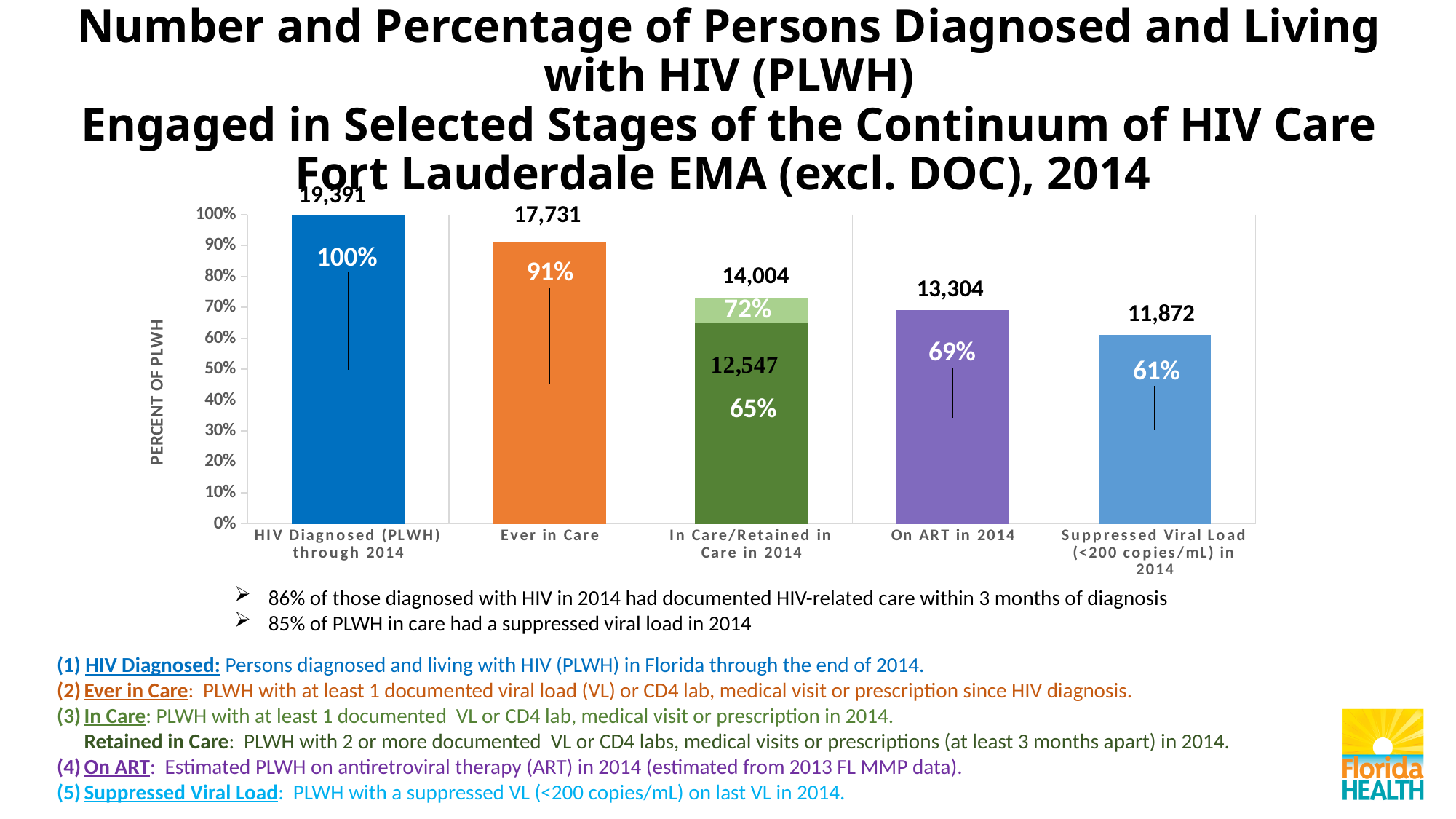
What percentage of PLWH is shown for the Ever in Care bar? 91% Which stage of the continuum has the lowest percentage of PLWH? Suppressed Viral Load (<200 copies/mL) in 2014 What percentage is shown for Suppressed Viral Load (<200 copies/mL) in 2014? 61% What percentage is shown for Retained in Care (the darker green portion of the In Care/Retained in Care bar)? 65% What type of chart is shown on the slide? Bar chart What number is printed above the On ART in 2014 bar? 13,304 How many stages of the continuum are shown on the x axis? 5 What is the difference in percentage points between Ever in Care and On ART in 2014? 22% What number is printed above the HIV Diagnosed (PLWH) through 2014 bar? 19,391 Which stage of the continuum has the highest percentage of PLWH? HIV Diagnosed (PLWH) through 2014 What is the difference between the number Ever in Care and the number with Suppressed Viral Load in 2014? 5,859 Which is larger, the percentage for In Care (72%) or the percentage for On ART in 2014? In Care (72%)